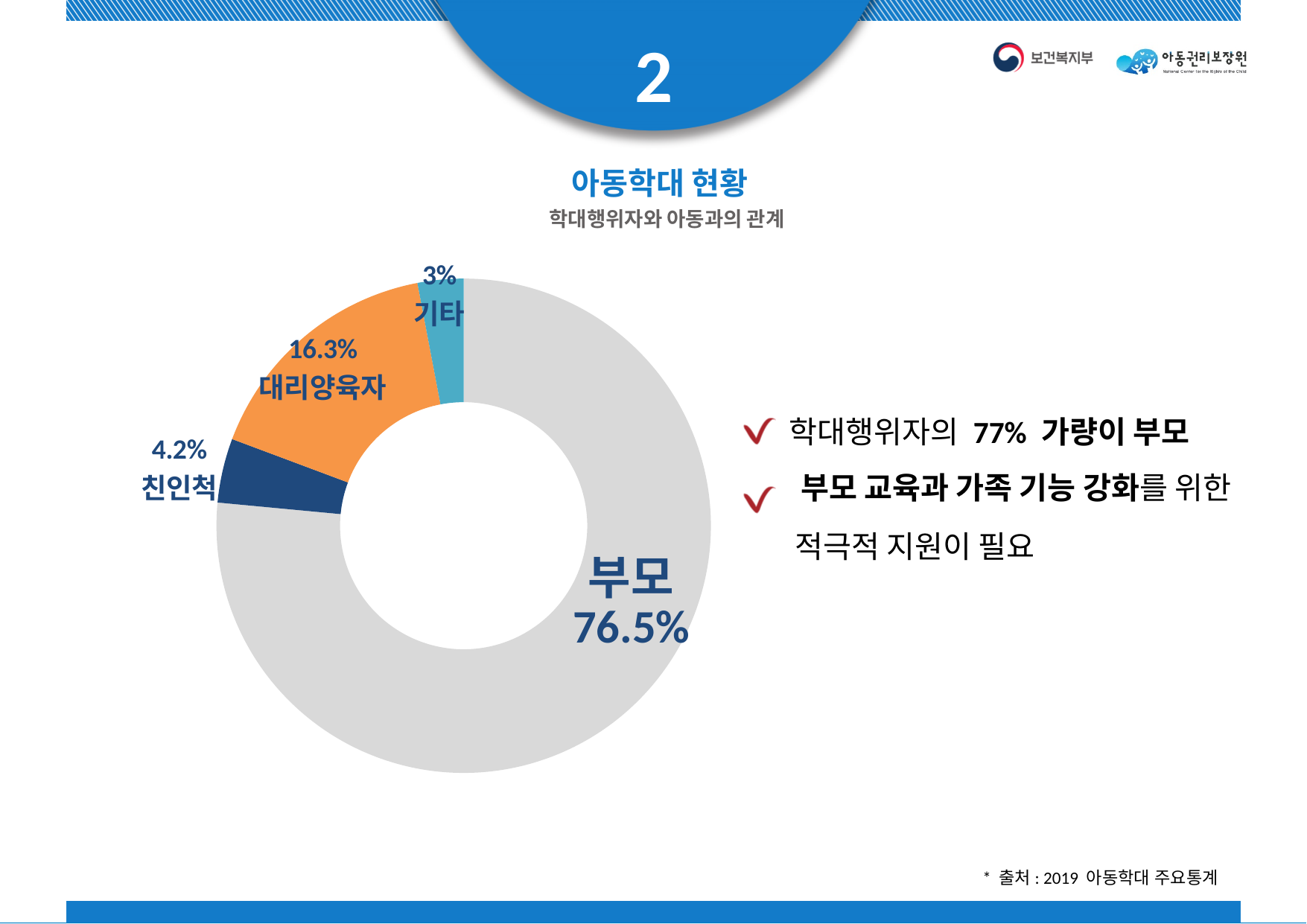
What kind of chart is shown on the slide? doughnut chart What percentage is shown for 대리양육자? 16.3% Which is larger, the share for 친인척 or the share for 기타? 친인척 What colour is the 대리양육자 slice? orange What percentage is shown for 부모? 76.5% How many categories are shown in the chart? 4 What is the subtitle of the chart? 학대행위자와 아동과의 관계 What percentage is shown for 기타? 3% Which category has the largest share of the chart? 부모 What percentage is shown for 친인척? 4.2% What is the difference between the shares of 부모 and 대리양육자? 60.2% Which category has the smallest share of the chart? 기타